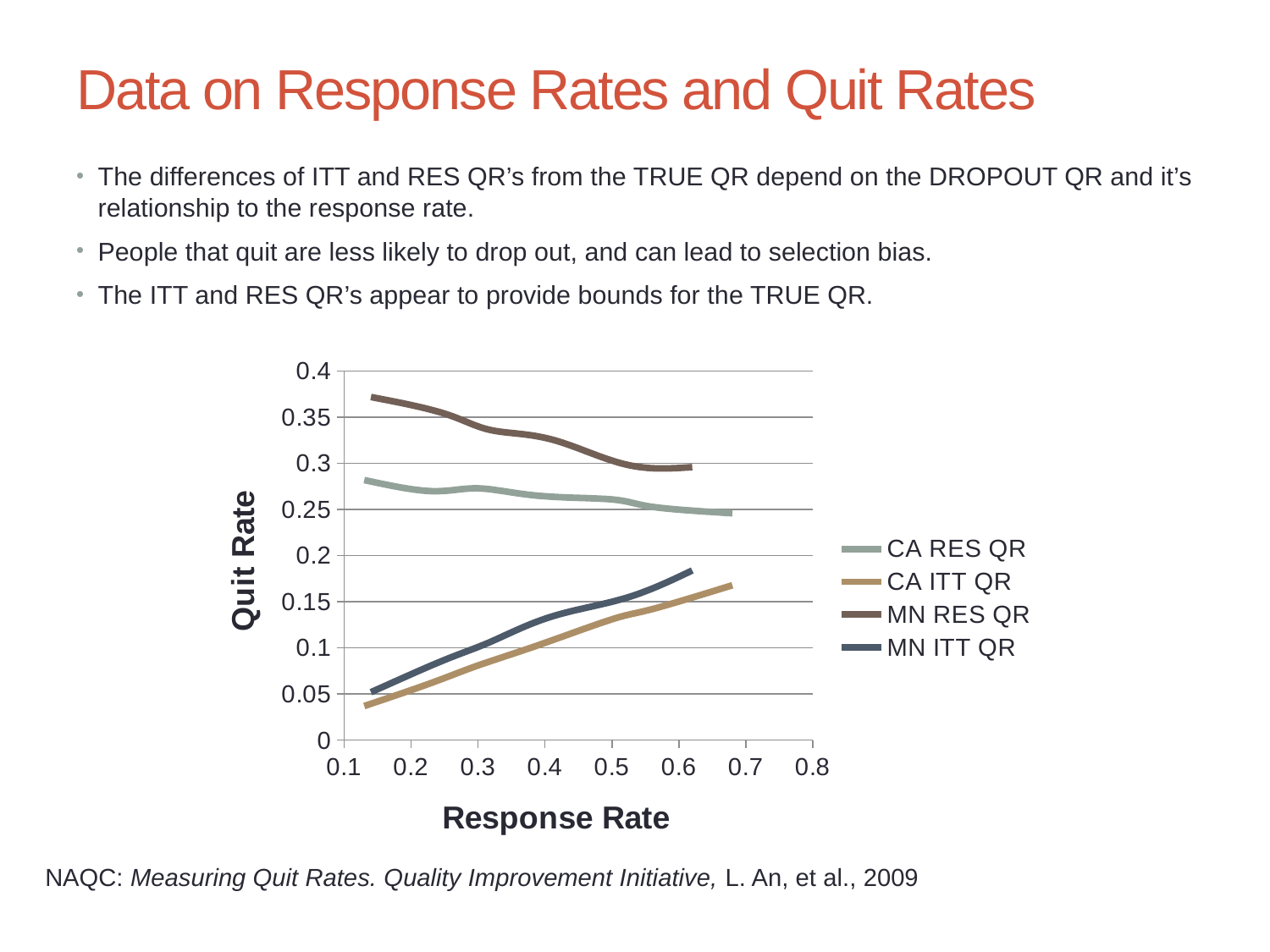
At a response rate of 0.4, which is larger: the MN RES QR quit rate or the CA RES QR quit rate? MN RES QR What is the title of the horizontal axis? Response Rate Does the MN RES QR line rise or fall as the response rate increases? fall How many series does the legend list? 4 Is the CA RES QR quit rate at a response rate of 0.2 greater or less than 0.25? greater What is the title of the vertical axis? Quit Rate Is the MN RES QR quit rate at a response rate of 0.4 greater or less than 0.35? less What kind of chart is shown on the slide? line chart Does the CA ITT QR line rise or fall as the response rate increases? rise Does the MN ITT QR line rise or fall as the response rate increases? rise Which series has the highest quit rate values across the chart? MN RES QR Which series has the lowest quit rate values across the chart? CA ITT QR